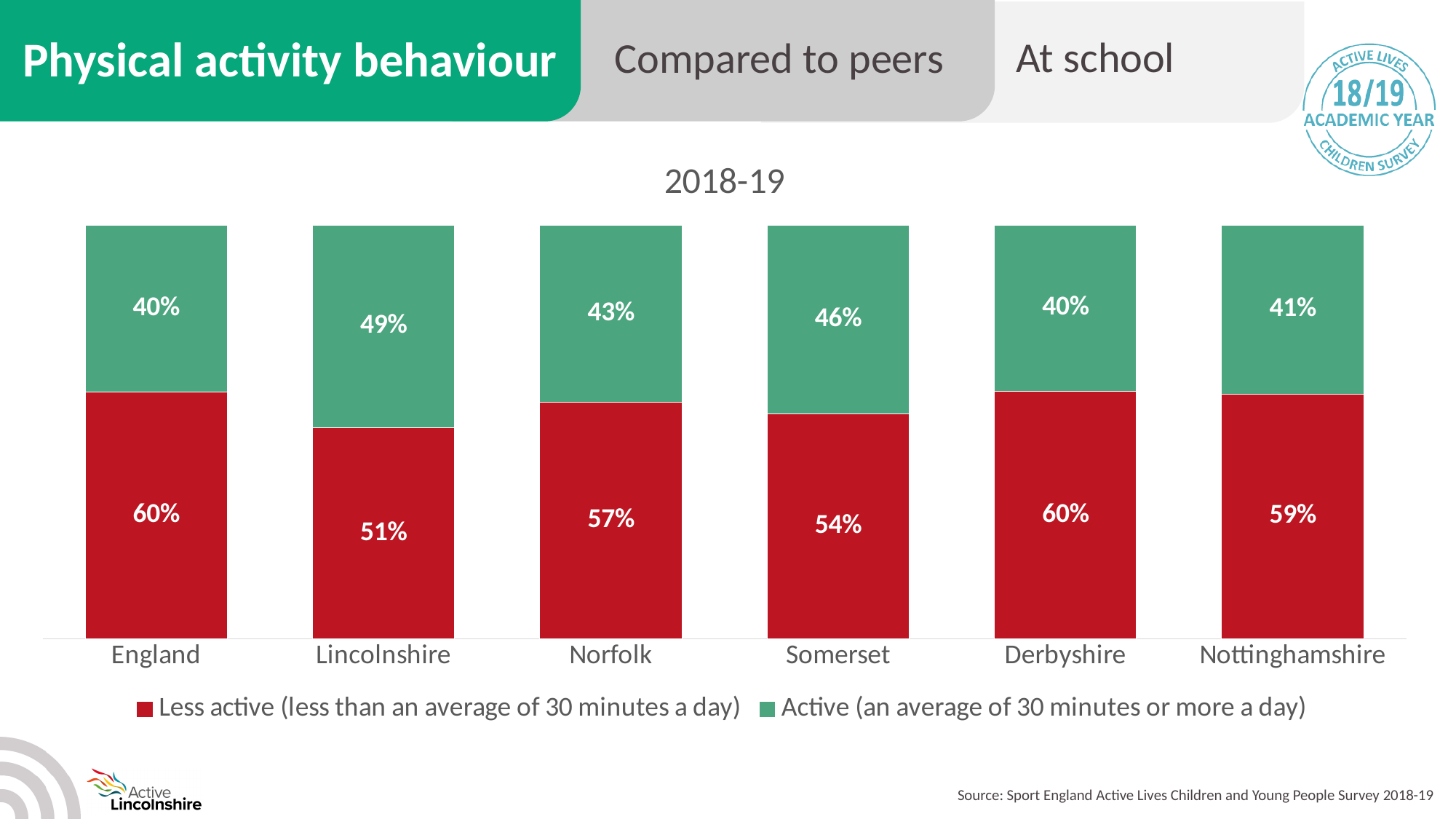
What percentage of children in Norfolk are Less active (less than an average of 30 minutes a day)? 57% Which area has the highest Active (an average of 30 minutes or more a day) percentage? Lincolnshire Which has a larger Active percentage, Norfolk or Nottinghamshire? Norfolk What is the total of the stacked bar for Derbyshire? 100% What is the Active value for Somerset? 46% How many areas are shown on the x axis? 6 Which area has the lowest Less active percentage? Lincolnshire How many series does the legend list? 2 What colour represents the Less active series? Red What percentage of children in Lincolnshire are Active (an average of 30 minutes or more a day)? 49% What kind of chart is shown on the slide? Stacked bar chart What is the difference between the Less active percentage for England and for Lincolnshire? 9%